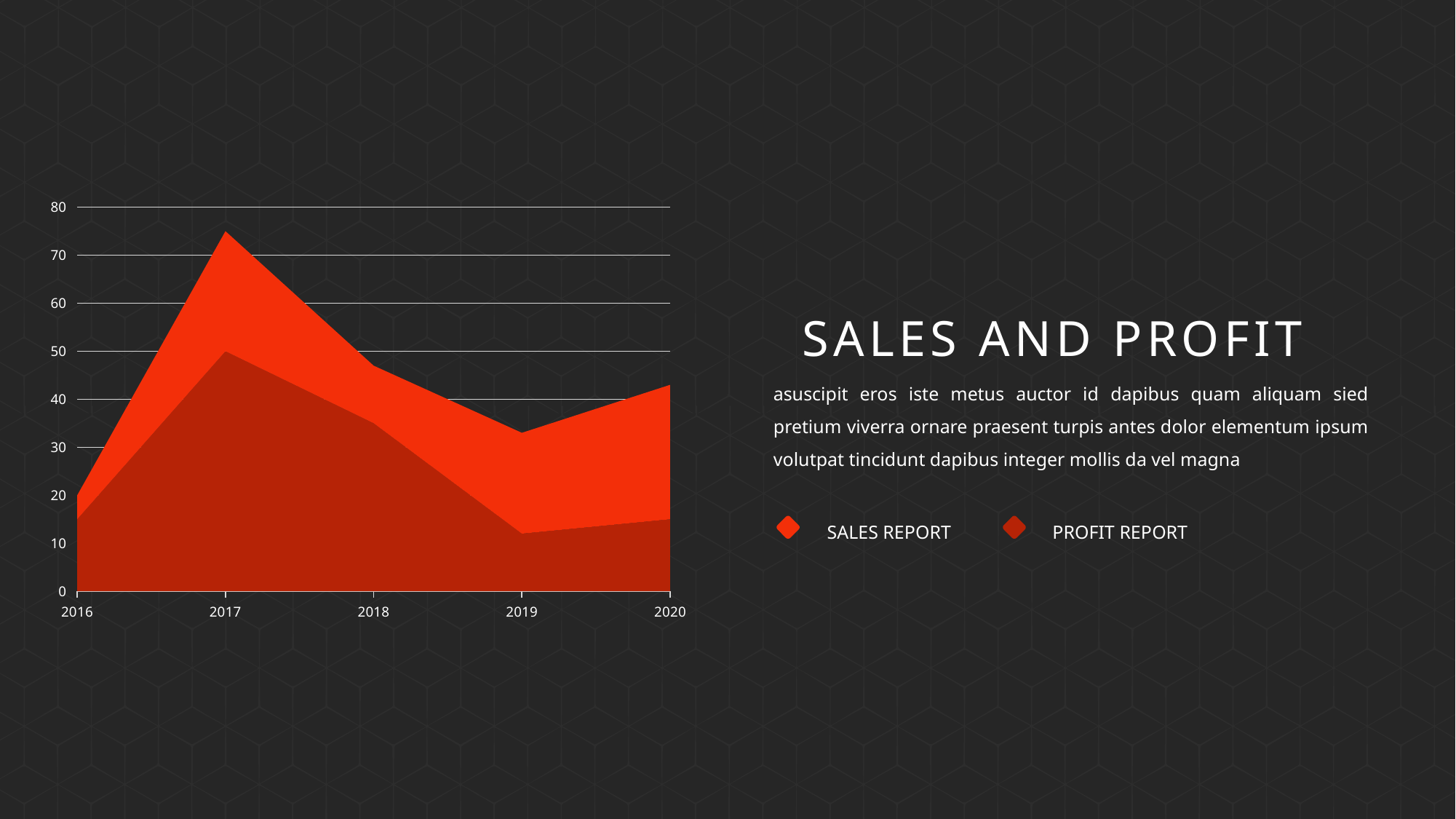
How many years are plotted along the x axis of the chart? 5 What kind of chart is shown on the slide? Area chart In which year does the Sales Report series reach its highest value? 2020 In which year does the Profit Report series reach its highest value? 2017 Is the Sales Report value for 2017 greater or less than 70? less Does the Sales Report series rise or fall from 2017 to 2019? Fall In which year is the Profit Report series at its lowest value? 2019 In which year is the Sales Report series at its lowest value? 2016 Is the Profit Report value for 2019 greater or less than 20? less How many series does the chart legend list? 2 Which is larger: the Profit Report value for 2018 or for 2019? 2018 Is the Sales Report value for 2019 greater or less than 40? less